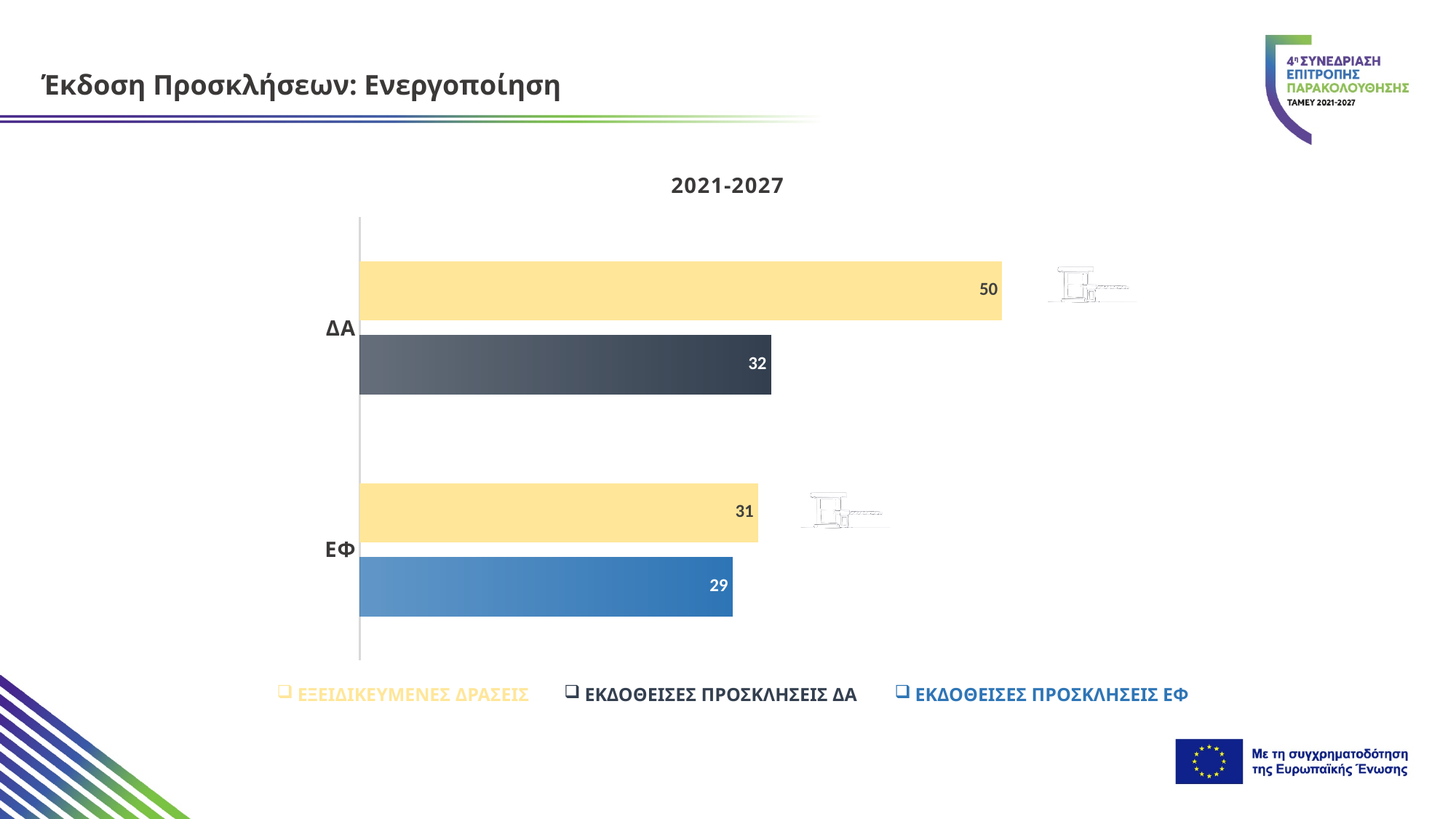
What is the value of ΕΚΔΟΘΕΙΣΕΣ ΠΡΟΣΚΛΗΣΕΙΣ ΔΑ for ΔΑ? 32 What is the value of ΕΞΕΙΔΙΚΕΥΜΕΝΕΣ ΔΡΑΣΕΙΣ for ΔΑ? 50 Which bar in the chart has the lowest value? ΕΚΔΟΘΕΙΣΕΣ ΠΡΟΣΚΛΗΣΕΙΣ ΕΦ for ΕΦ What is the value of ΕΞΕΙΔΙΚΕΥΜΕΝΕΣ ΔΡΑΣΕΙΣ for ΕΦ? 31 Which is larger: ΕΞΕΙΔΙΚΕΥΜΕΝΕΣ ΔΡΑΣΕΙΣ for ΔΑ or ΕΞΕΙΔΙΚΕΥΜΕΝΕΣ ΔΡΑΣΕΙΣ for ΕΦ? ΔΑ What is the difference between ΕΞΕΙΔΙΚΕΥΜΕΝΕΣ ΔΡΑΣΕΙΣ and ΕΚΔΟΘΕΙΣΕΣ ΠΡΟΣΚΛΗΣΕΙΣ ΕΦ for ΕΦ? 2 What type of chart is shown on the slide? Bar chart What is the difference between ΕΞΕΙΔΙΚΕΥΜΕΝΕΣ ΔΡΑΣΕΙΣ and ΕΚΔΟΘΕΙΣΕΣ ΠΡΟΣΚΛΗΣΕΙΣ ΔΑ for ΔΑ? 18 Which bar in the chart has the highest value? ΕΞΕΙΔΙΚΕΥΜΕΝΕΣ ΔΡΑΣΕΙΣ for ΔΑ How many series does the legend list? 3 How many categories are shown on the vertical axis of the chart? 2 What is the value of ΕΚΔΟΘΕΙΣΕΣ ΠΡΟΣΚΛΗΣΕΙΣ ΕΦ for ΕΦ? 29